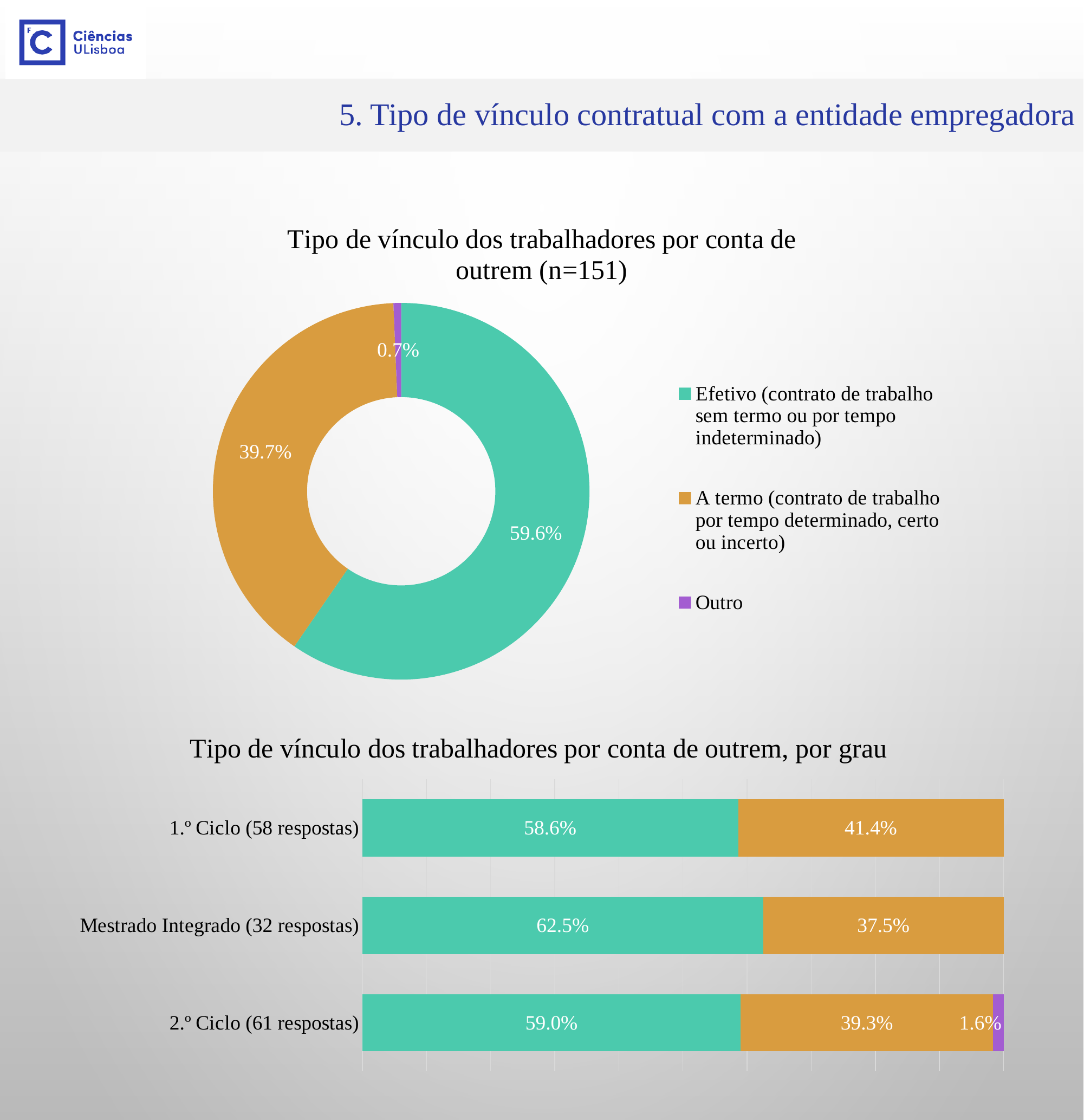
In the donut chart 'Tipo de vínculo dos trabalhadores por conta de outrem (n=151)', what is the difference between the 'Efetivo' share and the 'A termo' share? 19.9% In the donut chart 'Tipo de vínculo dos trabalhadores por conta de outrem (n=151)', what share is labelled for 'Outro'? 0.7% What kind of chart is 'Tipo de vínculo dos trabalhadores por conta de outrem, por grau'? Stacked bar chart In the donut chart 'Tipo de vínculo dos trabalhadores por conta de outrem (n=151)', which category has the smallest share? Outro In the donut chart 'Tipo de vínculo dos trabalhadores por conta de outrem (n=151)', what share is labelled for 'A termo (contrato de trabalho por tempo determinado, certo ou incerto)'? 39.7% In the bar chart 'Tipo de vínculo dos trabalhadores por conta de outrem, por grau', what is the 'Efetivo' (green) value for 'Mestrado Integrado (32 respostas)'? 62.5% In the donut chart 'Tipo de vínculo dos trabalhadores por conta de outrem (n=151)', how many entries does the legend list? 3 In the bar chart 'Tipo de vínculo dos trabalhadores por conta de outrem, por grau', how many categories (degree levels) are shown? 3 In the donut chart 'Tipo de vínculo dos trabalhadores por conta de outrem (n=151)', which category has the largest share? Efetivo (contrato de trabalho sem termo ou por tempo indeterminado) In the bar chart 'Tipo de vínculo dos trabalhadores por conta de outrem, por grau', what is the 'A termo' (orange) value for '1.º Ciclo (58 respostas)'? 41.4% In the bar chart 'Tipo de vínculo dos trabalhadores por conta de outrem, por grau', what is the 'Outro' (purple) value for '2.º Ciclo (61 respostas)'? 1.6% In the donut chart 'Tipo de vínculo dos trabalhadores por conta de outrem (n=151)', what share is labelled for 'Efetivo (contrato de trabalho sem termo ou por tempo indeterminado)'? 59.6%